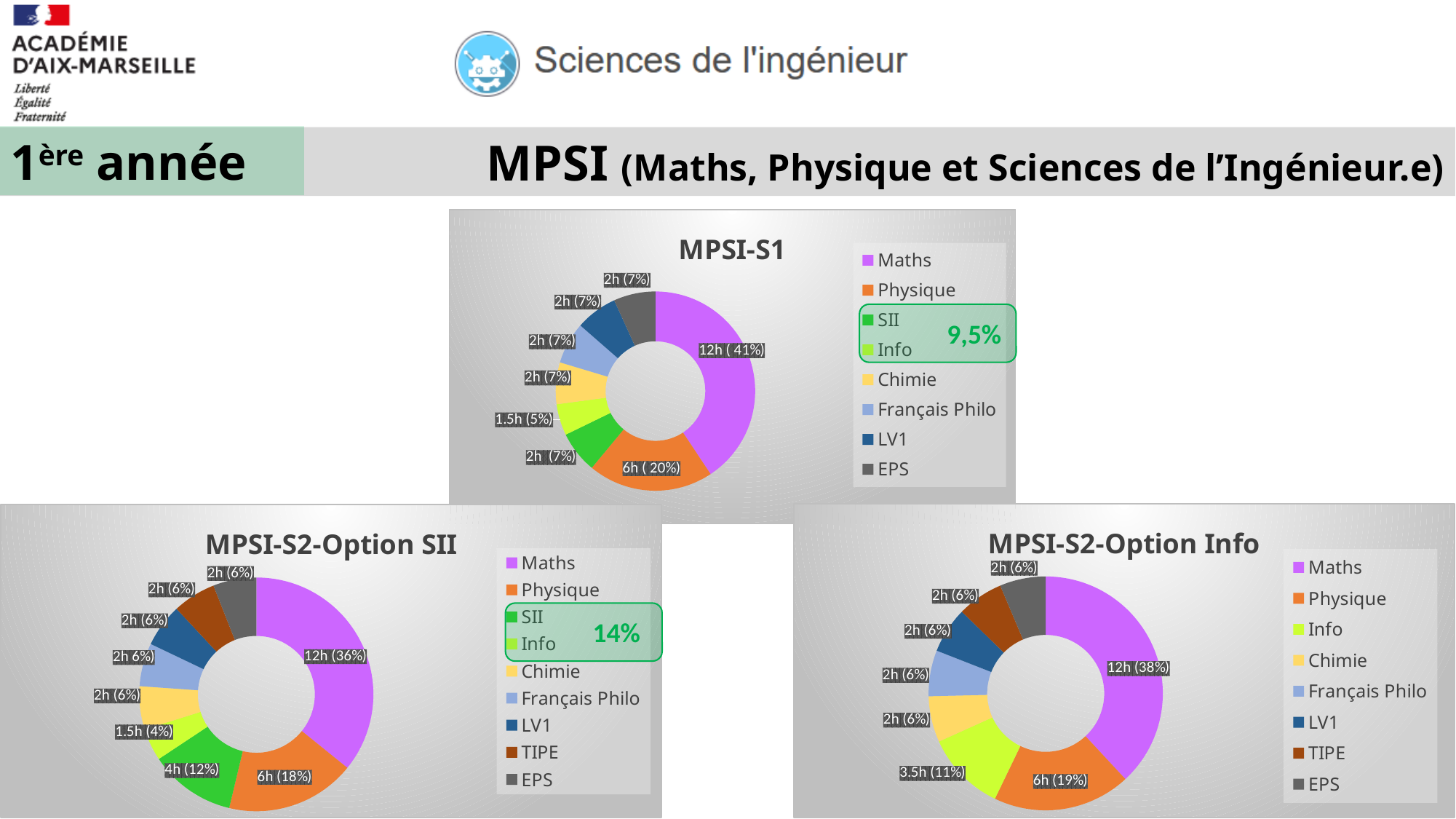
How many entries does the legend of the MPSI-S2-Option SII chart list? 9 In the MPSI-S1 chart, what is the value shown for Physique? 6h (20%) In the MPSI-S1 chart, what is the value shown for Maths? 12h (41%) How many entries does the legend of the MPSI-S1 chart list? 8 What type of chart is the MPSI-S1 chart? pie chart (donut) In the MPSI-S2-Option SII chart, what is the value shown for SII? 4h (12%) In the MPSI-S2-Option Info chart, what is the difference in hours between Maths and Physique? 6h In the MPSI-S1 chart, which subject has the smallest share? Info In the MPSI-S2-Option Info chart, which subject has the largest share? Maths In the MPSI-S2-Option SII chart, which is larger, SII or Info? SII In the MPSI-S2-Option Info chart, what is the value shown for Info? 3.5h (11%) In the MPSI-S2-Option SII chart, what percentage share does Maths have? 36%